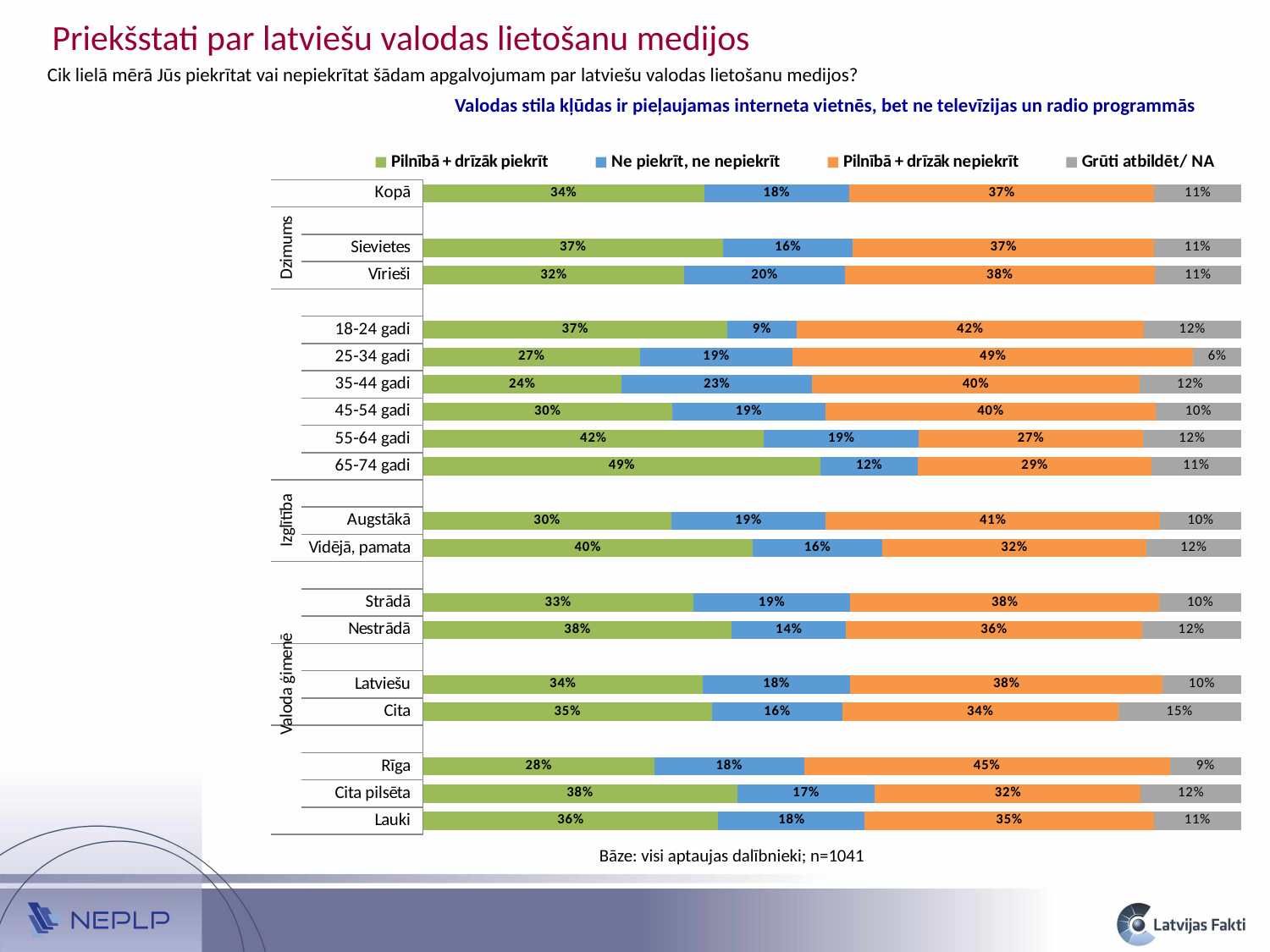
What is the 'Grūti atbildēt/ NA' value for the 'Cita' group? 15% What percentage of the 'Kopā' group falls in the 'Pilnībā + drīzāk piekrīt' category? 34% What kind of chart is shown on the slide? Stacked bar chart Which has a larger 'Ne piekrīt, ne nepiekrīt' value: 'Sievietes' or 'Vīrieši'? Vīrieši How many series does the legend list? 4 Which group has the lowest 'Pilnībā + drīzāk piekrīt' value? 35-44 gadi What is the total of the 'Pilnībā + drīzāk piekrīt' and 'Ne piekrīt, ne nepiekrīt' segments for the '55-64 gadi' bar? 61% What is the 'Pilnībā + drīzāk nepiekrīt' value for the '25-34 gadi' group? 49% What is the difference between the 'Pilnībā + drīzāk nepiekrīt' values for 'Rīga' and 'Lauki'? 10% Which group has the highest 'Pilnībā + drīzāk piekrīt' value? 65-74 gadi Which colour represents the 'Grūti atbildēt/ NA' series in the chart? Grey How many groups (bars) are shown in the chart? 18